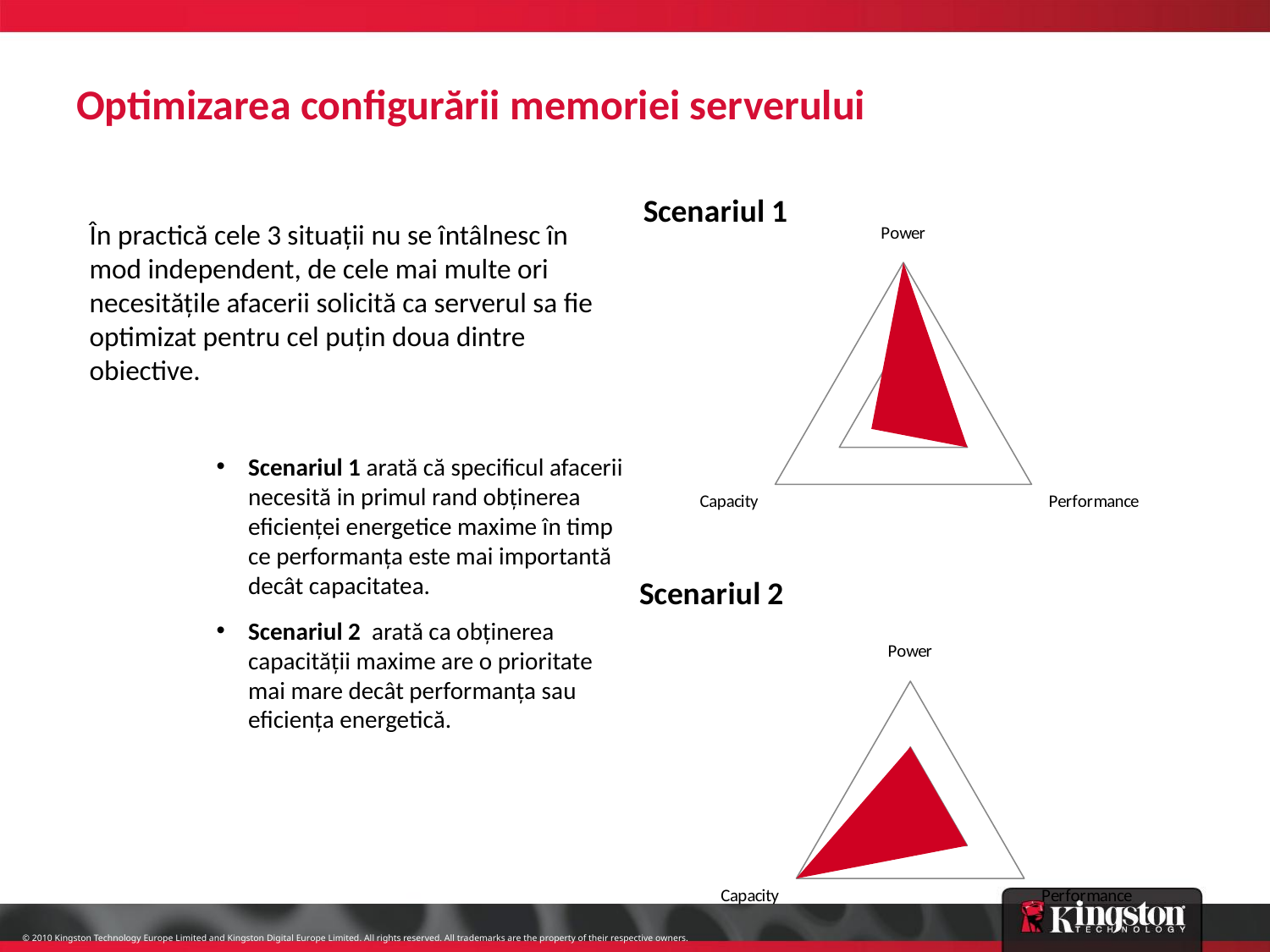
How many axes (categories) does the Scenariul 2 chart have? 3 How many axes (categories) does the Scenariul 1 chart have? 3 In the Scenariul 1 chart, which is larger: Performance or Capacity? Performance In the Scenariul 1 chart, which category has the lowest value? Capacity In the Scenariul 1 chart, which category has the highest value? Power What kind of chart is used for Scenariul 1? Radar chart What kind of chart is used for Scenariul 2? Radar chart In the Scenariul 1 chart, which is larger: Power or Performance? Power In the Scenariul 2 chart, which is larger: Capacity or Power? Capacity What colour is the filled data area in the Scenariul 1 chart? Red In the Scenariul 2 chart, which category has the highest value? Capacity What are the three axis labels on the Scenariul 2 chart? Power, Capacity, Performance